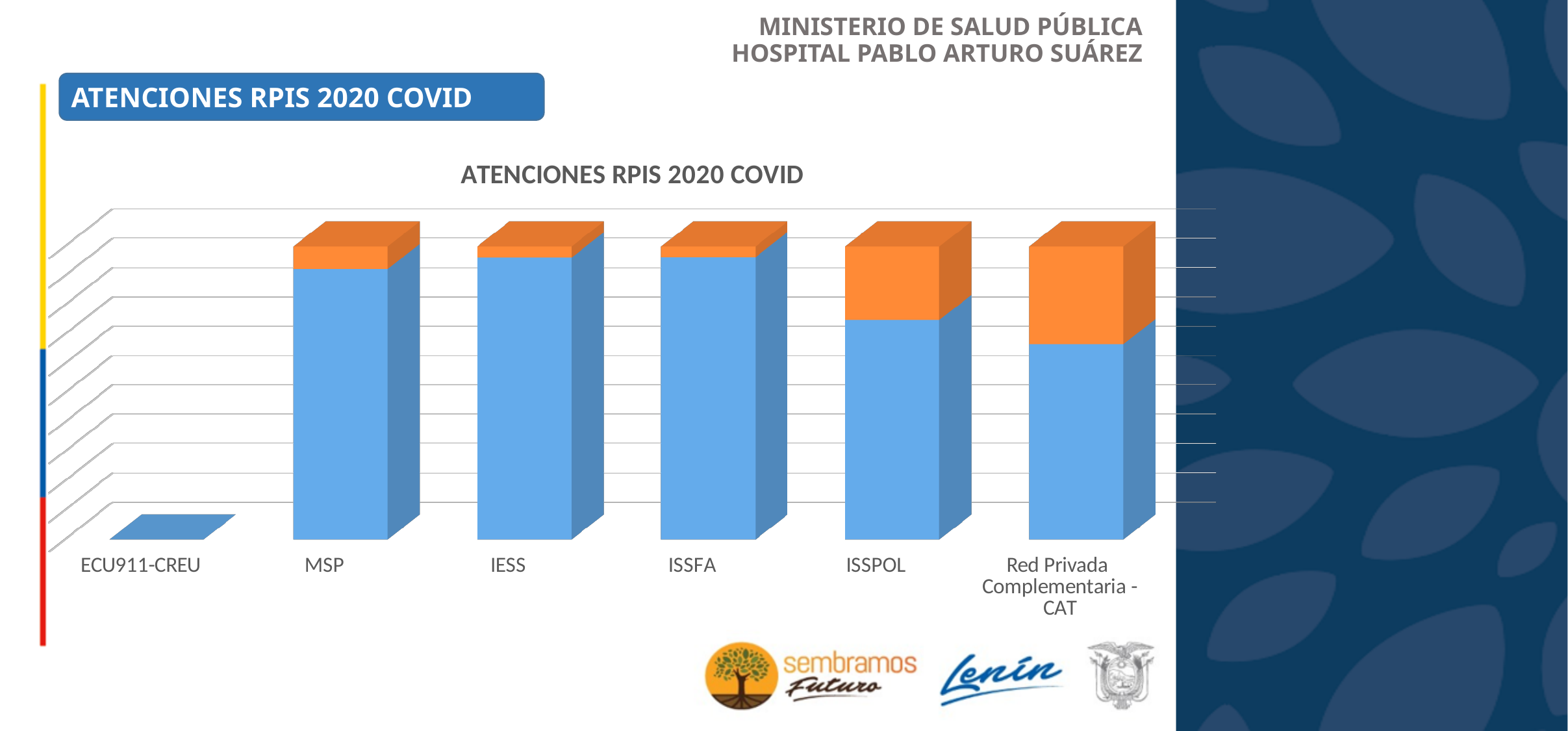
Is the orange segment larger for ISSPOL or for IESS? ISSPOL What is the title of the chart? ATENCIONES RPIS 2020 COVID What two colours are used for the stacked segments in the chart? Blue and orange Which category is listed first on the x axis of the chart? ECU911-CREU Among the categories with a visible bar, which has the smallest blue segment? Red Privada Complementaria - CAT How many categories have an orange segment in their bar? 5 Which category has the lowest total bar in the chart? ECU911-CREU Is the orange segment larger for Red Privada Complementaria - CAT or for ISSPOL? Red Privada Complementaria - CAT Is the blue segment larger for MSP or for ISSPOL? MSP What kind of chart is shown on the slide? Stacked bar chart How many categories are shown on the x axis of the chart? 6 Which category has the largest orange segment in the chart? Red Privada Complementaria - CAT